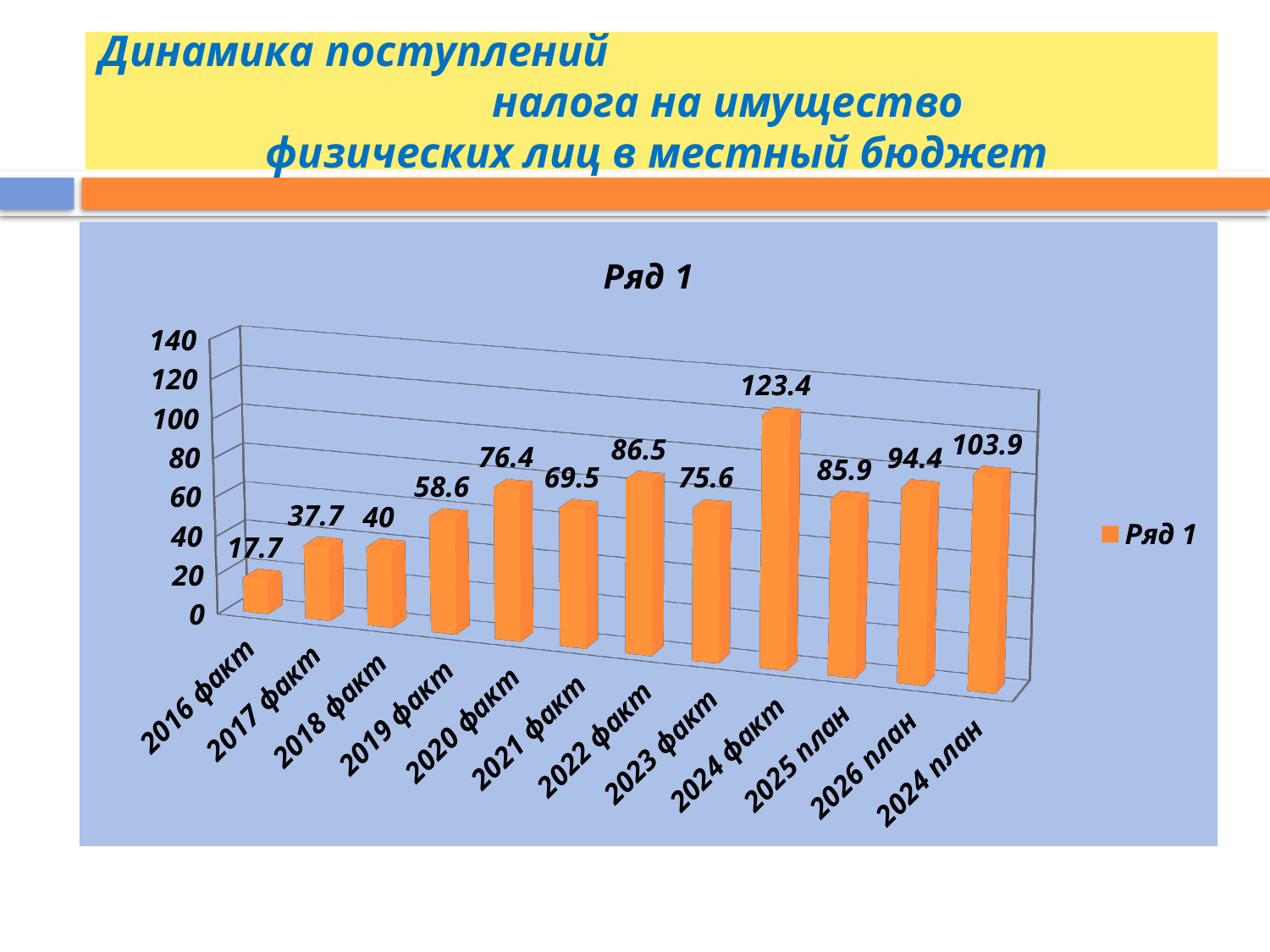
What is the difference between the values for 2024 факт and 2024 план? 19.5 What is the value for 2016 факт? 17.7 How many categories are shown on the x axis? 12 What is the value for 2018 факт? 40 Which category has the lowest value? 2016 факт Which category has the highest value? 2024 факт What is the title of the chart? Ряд 1 What kind of chart is shown on the slide? bar chart How many series does the legend list? 1 What is the value for 2024 факт? 123.4 What is the value for 2026 план? 94.4 Which is larger, the value for 2020 факт or the value for 2021 факт? 2020 факт